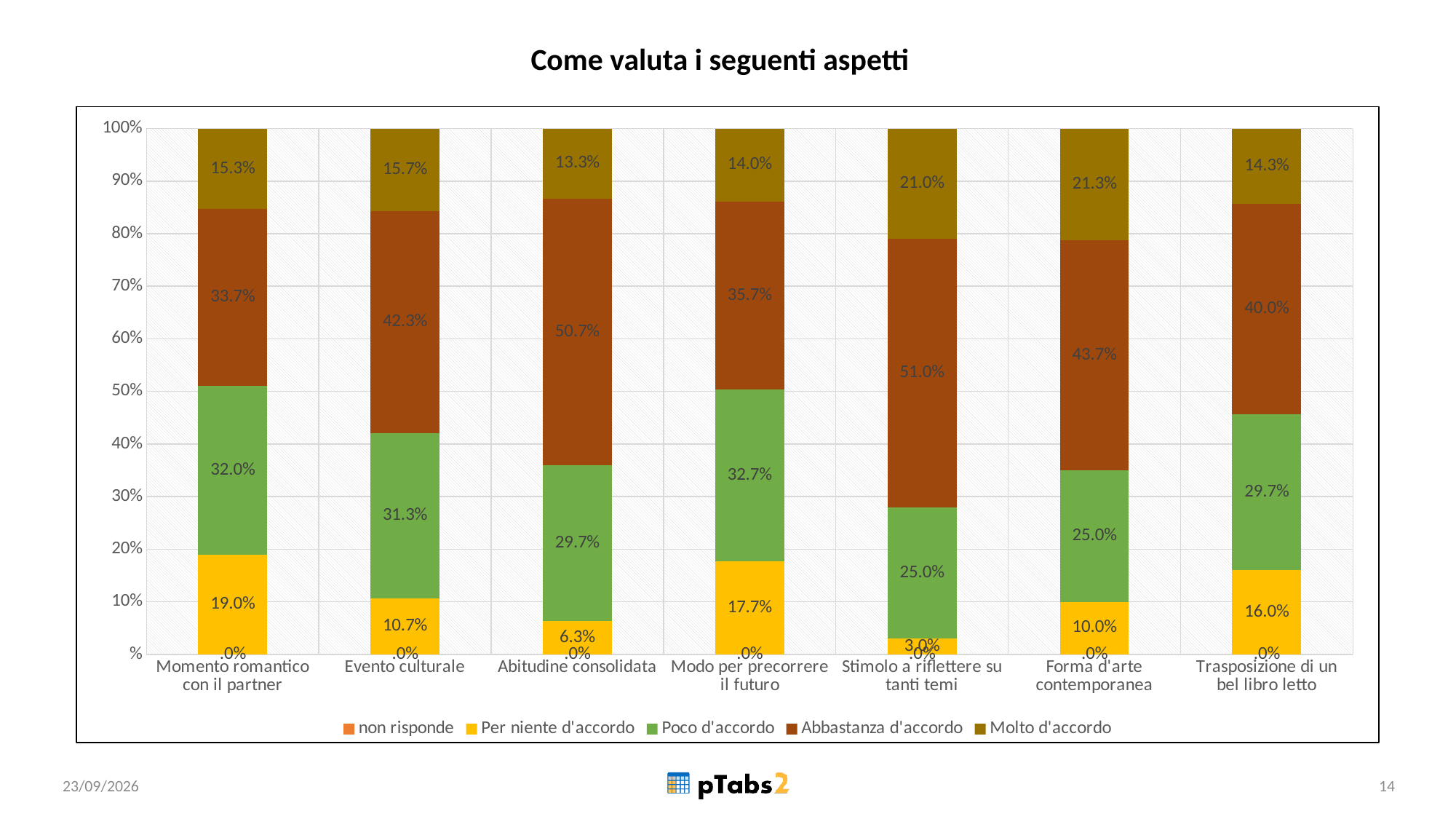
Which category has the highest value for "Abbastanza d'accordo"? Stimolo a riflettere su tanti temi What is the value of "Per niente d'accordo" for "Momento romantico con il partner"? 19.0% What is the title of the chart? Come valuta i seguenti aspetti What is the value of "Molto d'accordo" for "Forma d'arte contemporanea"? 21.3% Which is larger: "Molto d'accordo" for "Stimolo a riflettere su tanti temi" or for "Abitudine consolidata"? Stimolo a riflettere su tanti temi Which category has the lowest value for "Per niente d'accordo"? Stimolo a riflettere su tanti temi How many series does the legend list? 5 What is the value of "Poco d'accordo" for "Trasposizione di un bel libro letto"? 29.7% How many categories are shown on the x axis? 7 What is the difference between the "Abbastanza d'accordo" values for "Evento culturale" and "Momento romantico con il partner"? 8.6% What kind of chart is shown on the slide? Stacked bar chart What is the value of "Abbastanza d'accordo" for "Abitudine consolidata"? 50.7%